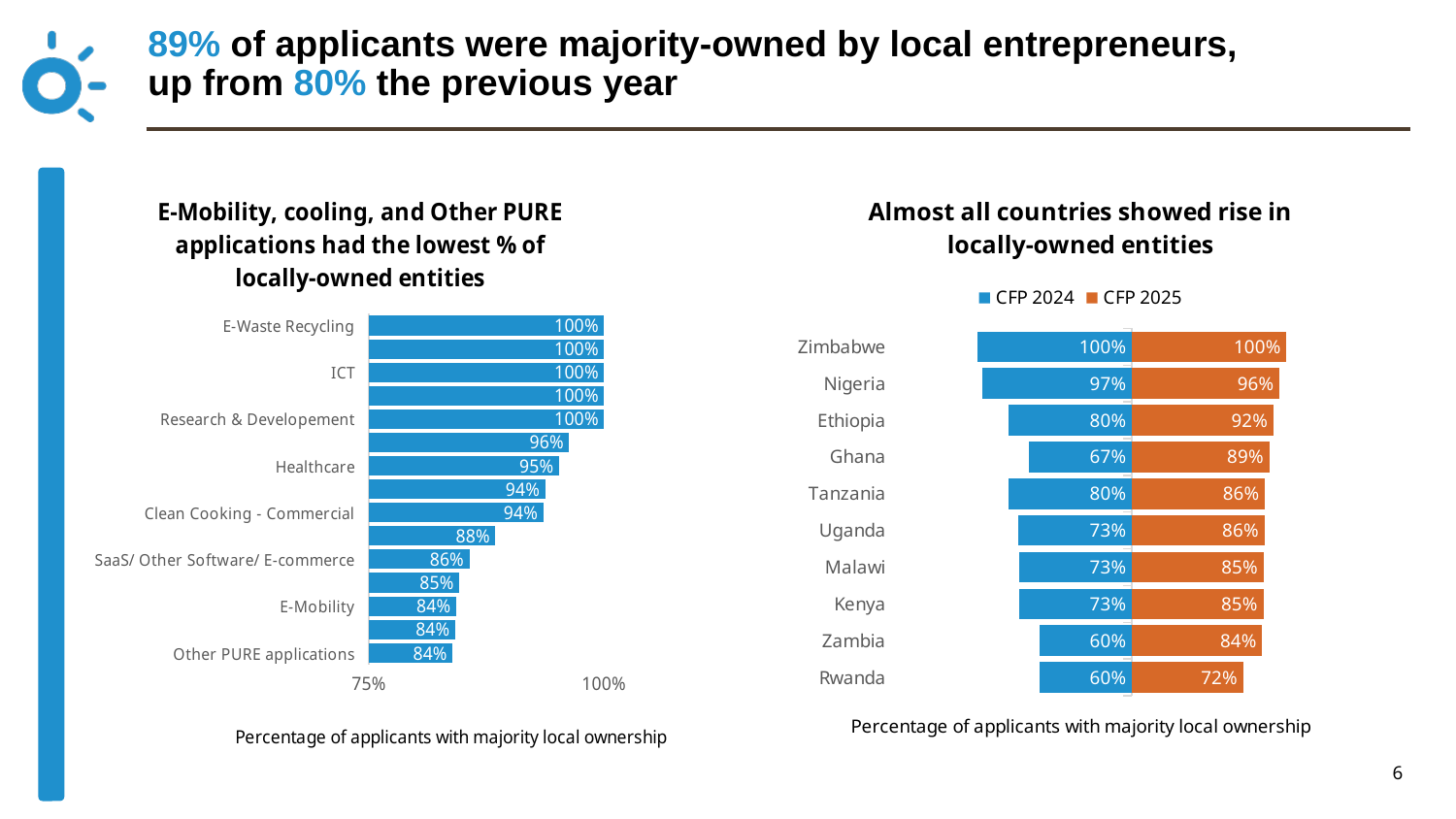
In the left chart, what is the value for Healthcare? 95% What type of chart is the right chart? Bar chart In the left chart, which is larger, the value for Research & Development or the value for Other PURE applications? Research & Development In the right chart, which country has the lowest CFP 2025 value? Rwanda In the left chart, what is the value for E-Mobility? 84% In the left chart, what is the value for SaaS/ Other Software/ E-commerce? 86% In the right chart, how many countries are shown? 10 In the right chart, what is the CFP 2025 value for Ghana? 89% In the right chart, what is the difference between the CFP 2025 and CFP 2024 values for Ghana? 22% In the right chart, what is the CFP 2024 value for Zambia? 60% In the right chart, how many series does the legend list? 2 In the left chart, what is the difference between the values for ICT and Clean Cooking - Commercial? 6%